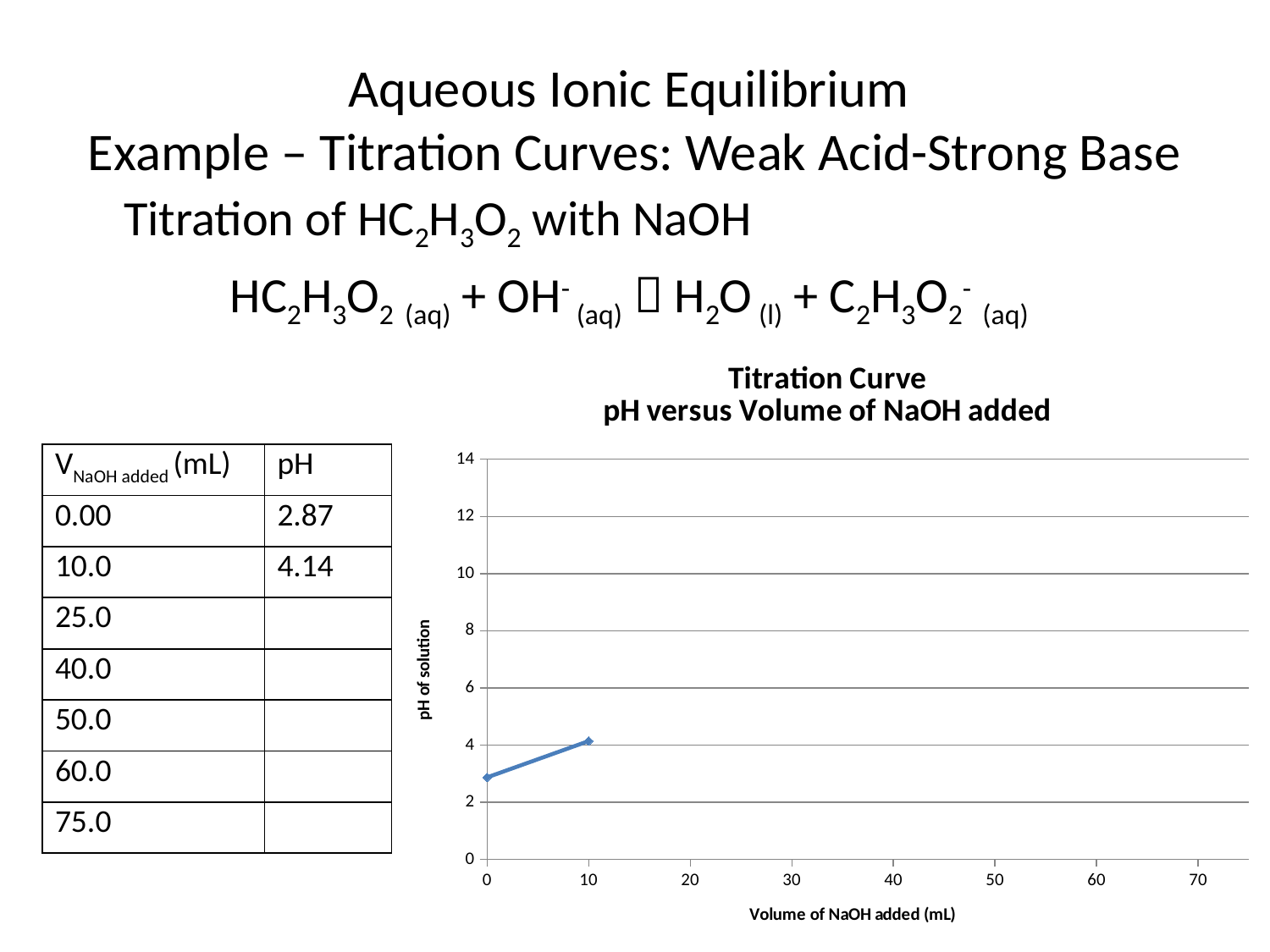
Which plotted point has the higher pH, the one at 0 mL or the one at 10 mL of NaOH added? 10 mL Is the pH at 0 mL of NaOH added greater or less than 2? greater Is the pH at 10 mL of NaOH added greater or less than 6? less What kind of chart is shown on the slide? line chart What is the label on the x axis of the chart? Volume of NaOH added (mL) Does the pH rise or fall as the volume of NaOH added increases from 0 to 10 mL? rise What is the title of the chart? Titration Curve pH versus Volume of NaOH added How many data points are plotted on the titration curve? 2 What is the pH when 10.0 mL of NaOH has been added? 4.14 At which volume of NaOH added is the plotted pH highest? 10 mL What is the pH when 0.00 mL of NaOH has been added? 2.87 What is the difference in pH between 10.0 mL and 0.00 mL of NaOH added? 1.27